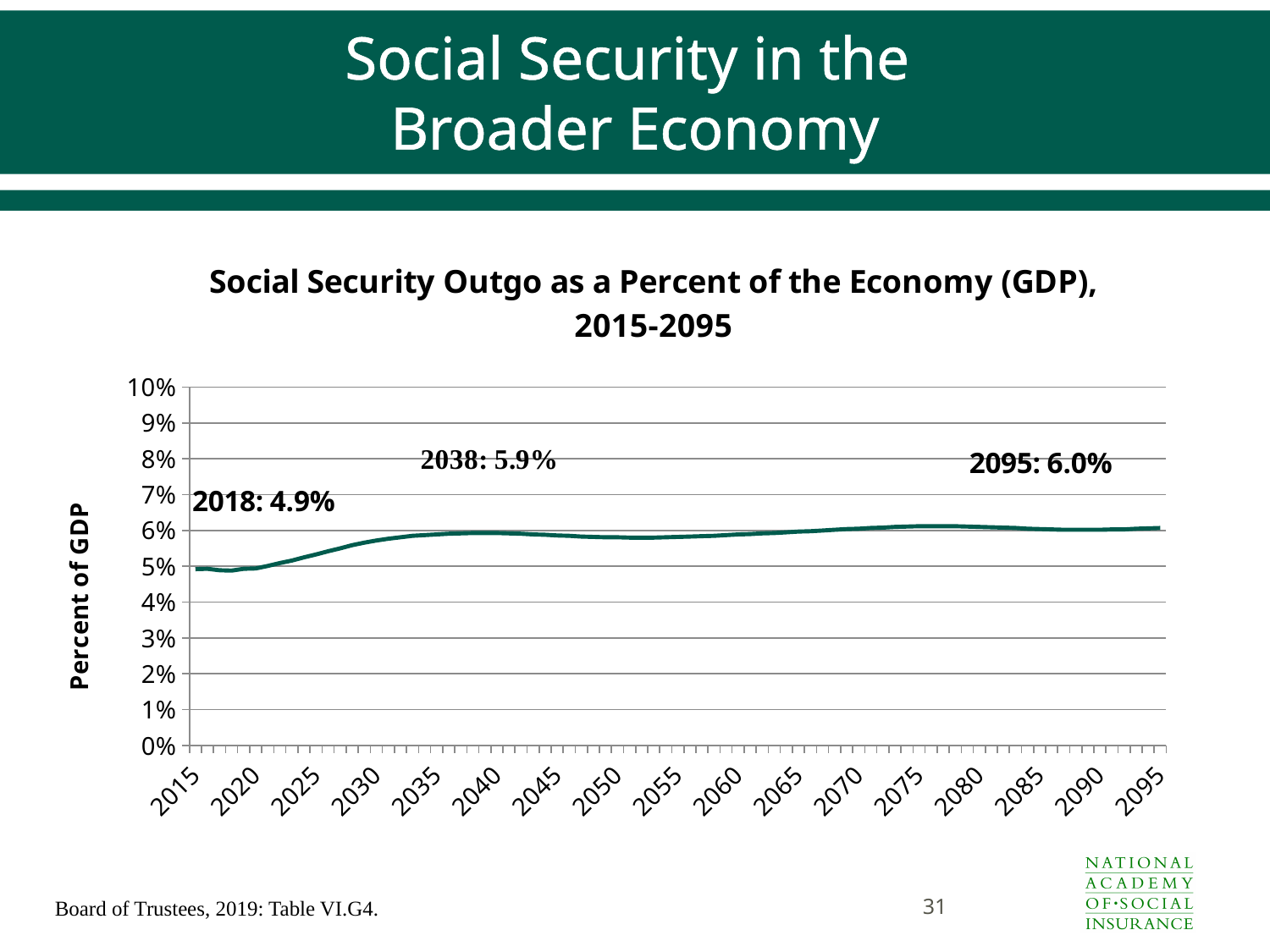
Which labelled year has the higher value, 2038 or 2095? 2095 Is the value for 2060 greater or less than 5%? greater What is the labelled value for 2038 on the chart? 5.9% By how many percentage points does the labelled 2038 value exceed the labelled 2018 value? 1.0 percentage points What is the labelled value for 2018 on the chart? 4.9% By how many percentage points does the labelled 2095 value exceed the labelled 2018 value? 1.1 percentage points What kind of chart is shown on the slide? Line chart What is the labelled value for 2095 on the chart? 6.0% What is the label on the vertical axis of the chart? Percent of GDP Which labelled year has the higher value, 2018 or 2095? 2095 Does the line rise or fall between 2020 and 2035? Rises Is the value for 2015 greater or less than 6%? less